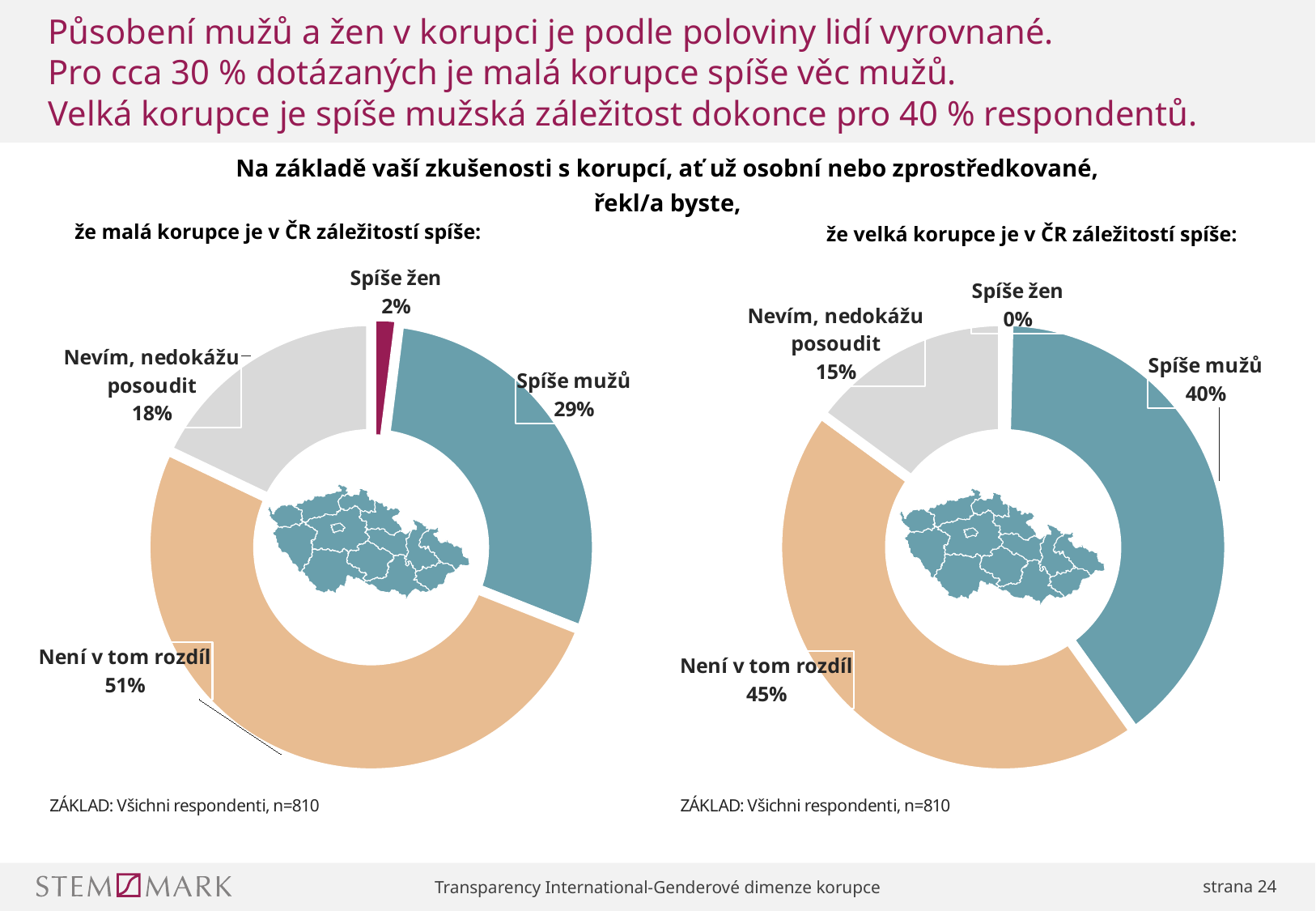
What type of chart is used on this slide? donut (pie) chart In the left chart (malá korupce), what percentage of respondents answered "Není v tom rozdíl"? 51% Which chart has a larger share for "Spíše mužů", the left (malá korupce) or the right (velká korupce)? right (velká korupce) What colour is the "Spíše mužů" slice in both charts? teal blue In the left chart (malá korupce), what percentage of respondents answered "Spíše žen"? 2% In the right chart (velká korupce), which category has the smallest share? Spíše žen How many categories are shown in the left chart (malá korupce)? 4 In the right chart (velká korupce), what is the difference in percentage points between "Není v tom rozdíl" and "Spíše mužů"? 5 In the left chart (malá korupce), what is the difference in percentage points between "Není v tom rozdíl" and "Spíše mužů"? 22 In the left chart (malá korupce), which category has the largest share? Není v tom rozdíl In the right chart (velká korupce), what percentage of respondents answered "Spíše mužů"? 40% In the right chart (velká korupce), what percentage of respondents answered "Nevím, nedokážu posoudit"? 15%